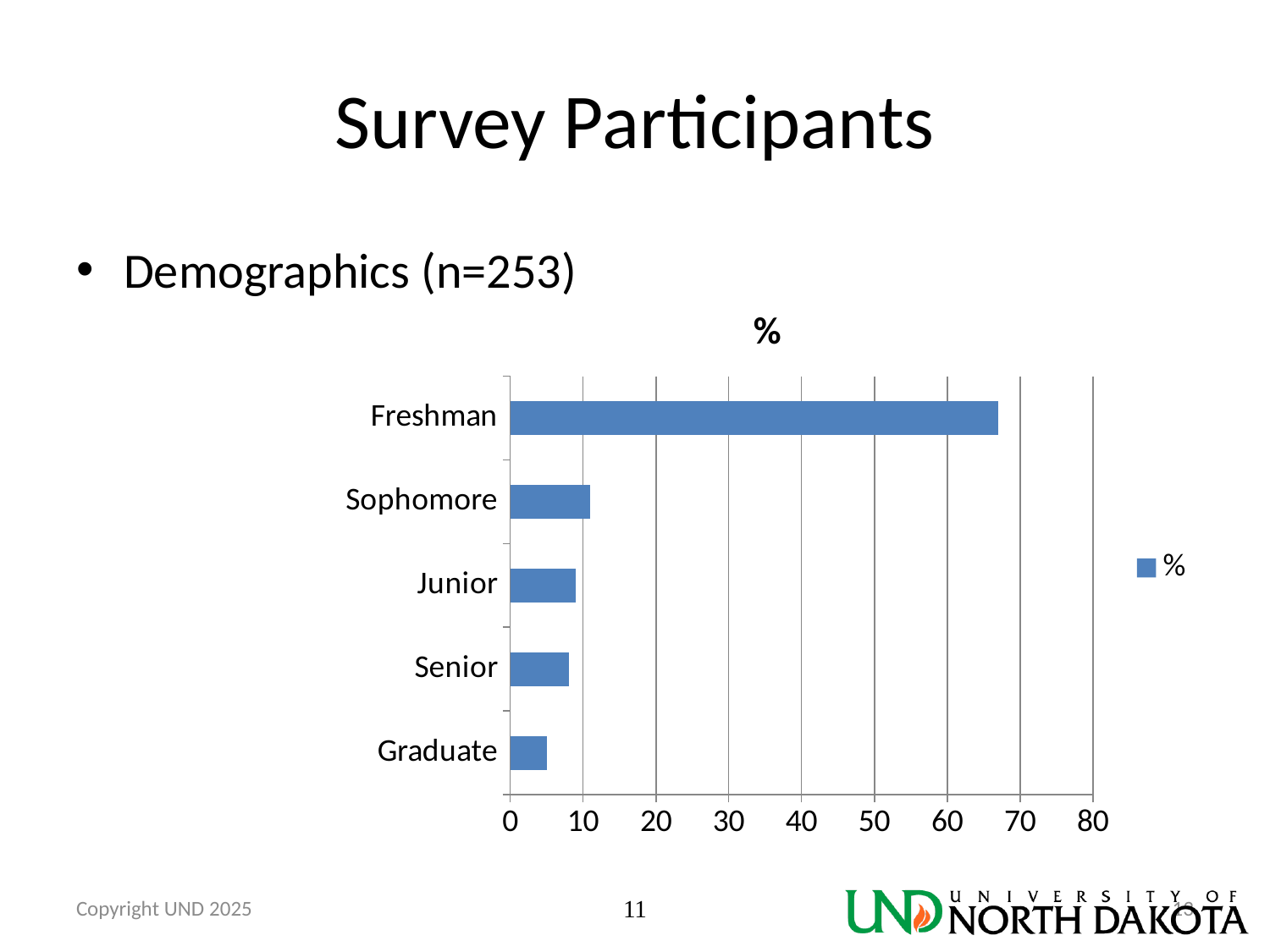
How many series does the chart legend list? 1 How many categories are plotted in the chart? 5 Which category has the lowest value in the chart? Graduate What kind of chart is shown on the slide? bar chart What is the title of the chart? % Is the value for Freshman greater or less than 60? greater Is the value for Graduate greater or less than 10? less Is the value for Senior greater or less than 10? less Which category has the highest value in the chart? Freshman Which is larger, the value for Sophomore or the value for Graduate? Sophomore Which is larger, the value for Junior or the value for Freshman? Freshman